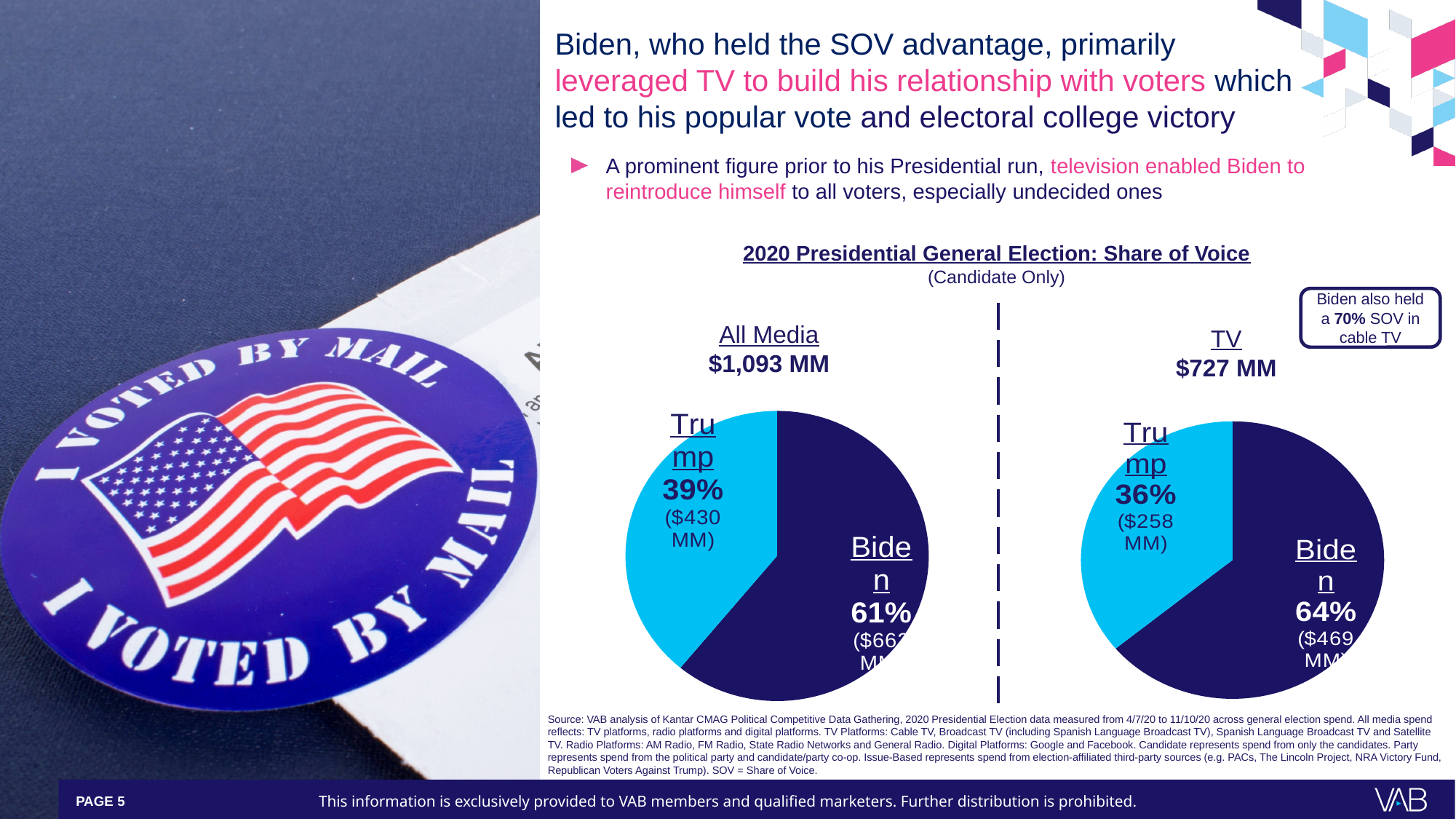
What type of chart is used to show the 2020 Presidential General Election share of voice? Pie chart In the TV pie chart, what share of voice does Trump hold? 36% In the TV pie chart, which candidate has the larger share of voice? Biden What is the total spend shown above the All Media pie chart? $1,093 MM In the All Media pie chart, what share of voice does Trump hold? 39% How many candidates are shown in each pie chart? 2 What is the total spend shown above the TV pie chart? $727 MM In the All Media pie chart, what is Trump's spend in dollars? $430 MM In the TV pie chart, what share of voice does Biden hold? 64% In the All Media pie chart, what is the difference in percentage points between Biden's and Trump's share of voice? 22 percentage points In the All Media pie chart, what share of voice does Biden hold? 61% In the TV pie chart, what is Trump's spend in dollars? $258 MM